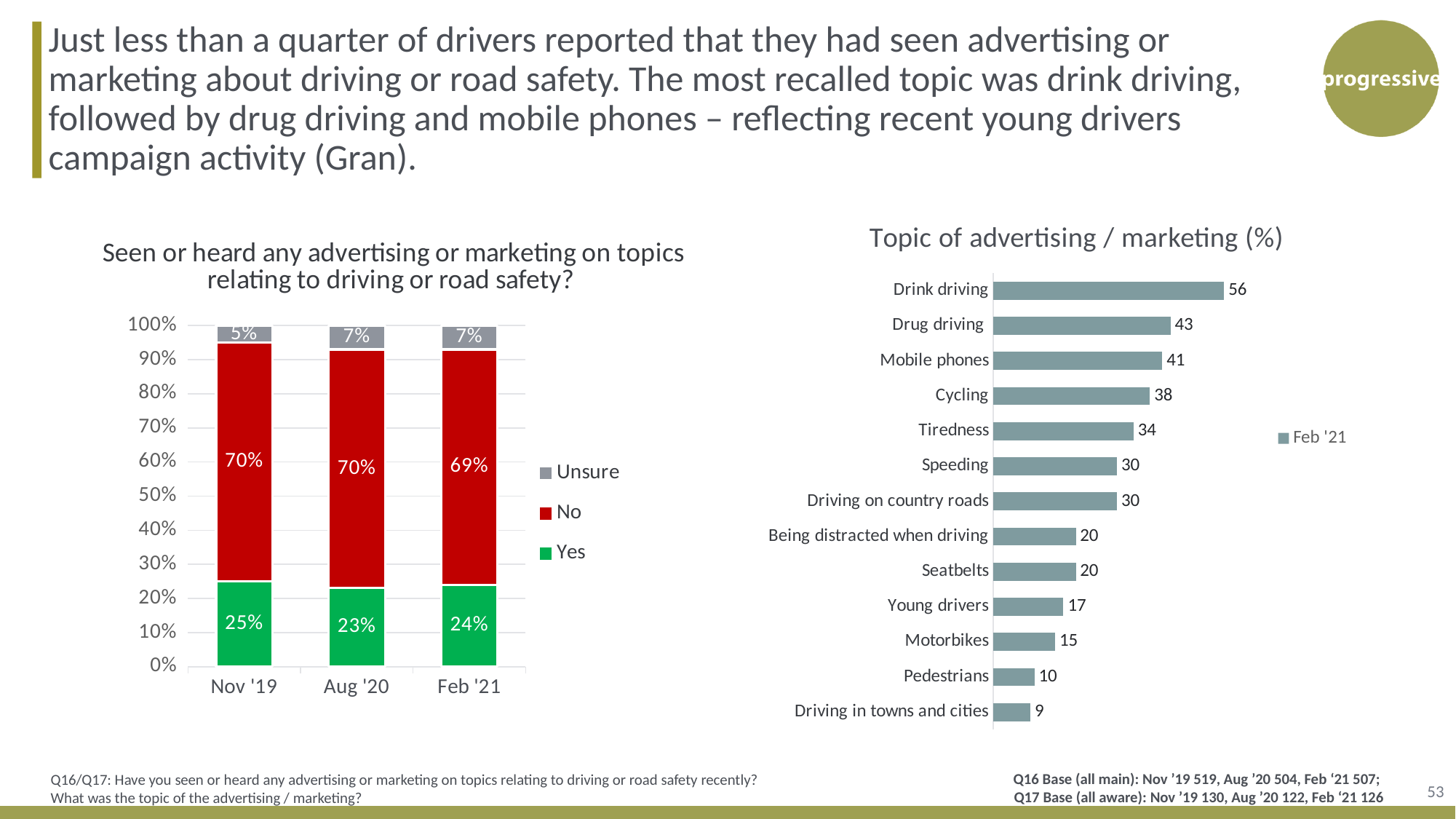
In the 'Seen or heard any advertising or marketing' chart, what percentage answered Unsure in Aug '20? 7% In the 'Topic of advertising / marketing (%)' chart, which topic has the highest value? Drink driving In the 'Topic of advertising / marketing (%)' chart, which is larger, Tiredness or Speeding? Tiredness In the 'Seen or heard any advertising or marketing' chart, what percentage answered No in Feb '21? 69% In the 'Seen or heard any advertising or marketing' chart, what percentage answered Yes in Nov '19? 25% In the 'Seen or heard any advertising or marketing' chart, how many series does the legend list? 3 In the 'Topic of advertising / marketing (%)' chart, how many topics are shown? 13 In the 'Seen or heard any advertising or marketing' chart, what is the difference between the Yes share in Nov '19 and Aug '20? 2% In the 'Topic of advertising / marketing (%)' chart, what is the difference between Drink driving and Drug driving? 13 In the 'Topic of advertising / marketing (%)' chart, which topic has the lowest value? Driving in towns and cities In the 'Topic of advertising / marketing (%)' chart, what is the value for Cycling? 38 What kind of chart is the 'Topic of advertising / marketing (%)' chart? Bar chart